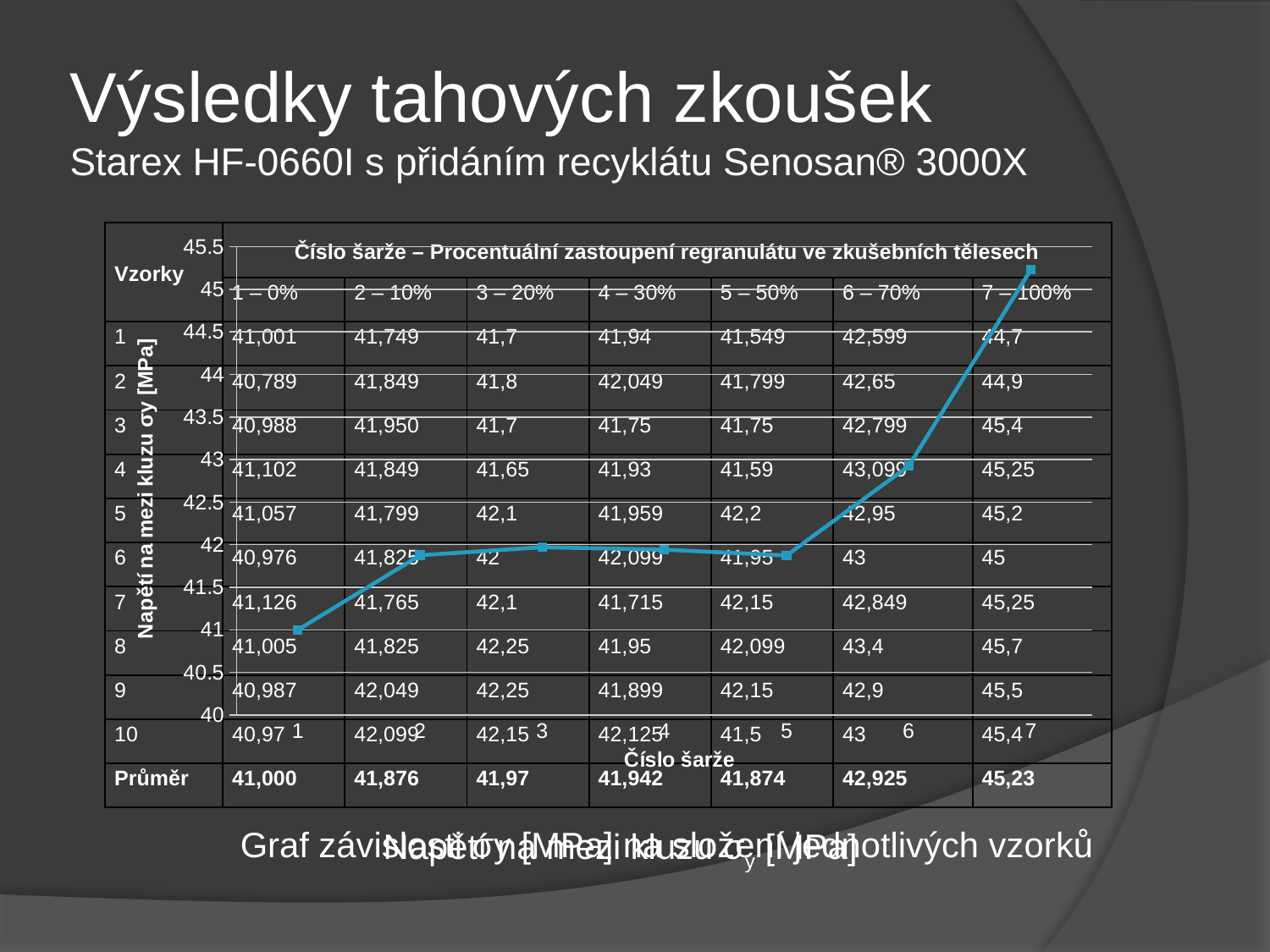
What is the label of the horizontal axis of the chart? Číslo šarže Is the plotted value for batch 6 greater or less than 42.5? greater Is the plotted value for batch 5 greater or less than 42.5? less What is the label of the vertical axis of the chart? Napětí na mezi kluzu σy [MPa] Which batch number (Číslo šarže) has the lowest plotted value? 1 Is the plotted value for batch 7 greater or less than 45? greater Do the plotted values generally rise or fall as the batch number increases from 1 to 7? rise How many data points are plotted on the line chart? 7 Which has the larger plotted value, batch 6 or batch 2? batch 6 Which batch number (Číslo šarže) has the highest plotted value? 7 What kind of chart is shown on the slide? line chart